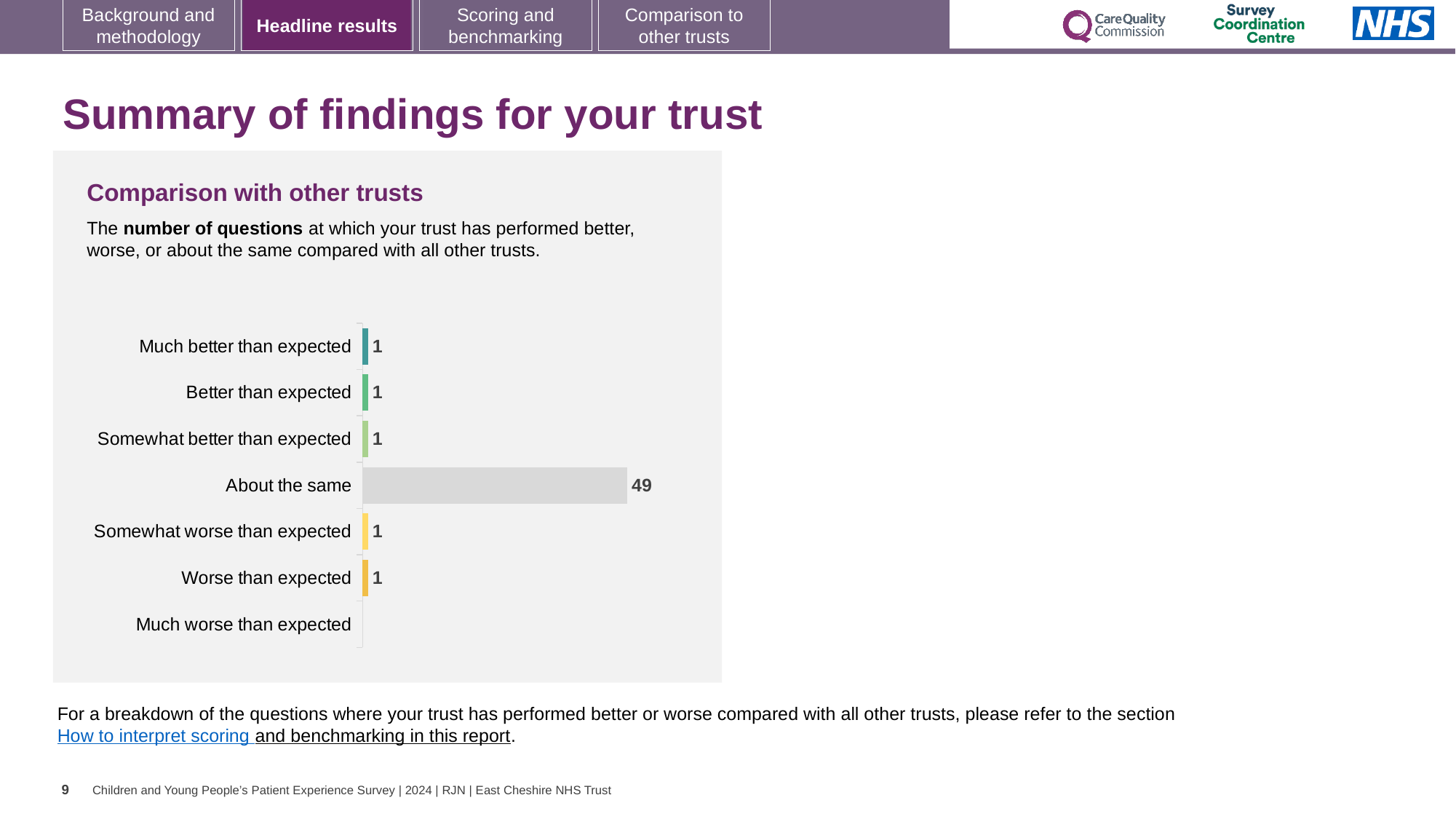
How many questions were rated 'Much better than expected'? 1 How many questions were rated 'Worse than expected'? 1 What is the difference between the number of questions rated 'About the same' and 'Better than expected'? 48 Which is larger: the value for 'About the same' or the value for 'Somewhat worse than expected'? About the same How many categories are shown on the chart? 7 What is the total number of questions across all categories shown on the chart? 54 Which category has no bar shown on the chart? Much worse than expected What is the title of the chart section? Comparison with other trusts Which category has the highest number of questions? About the same How many questions were rated 'Somewhat better than expected'? 1 How many questions were rated 'About the same'? 49 What kind of chart is shown on the slide? Bar chart